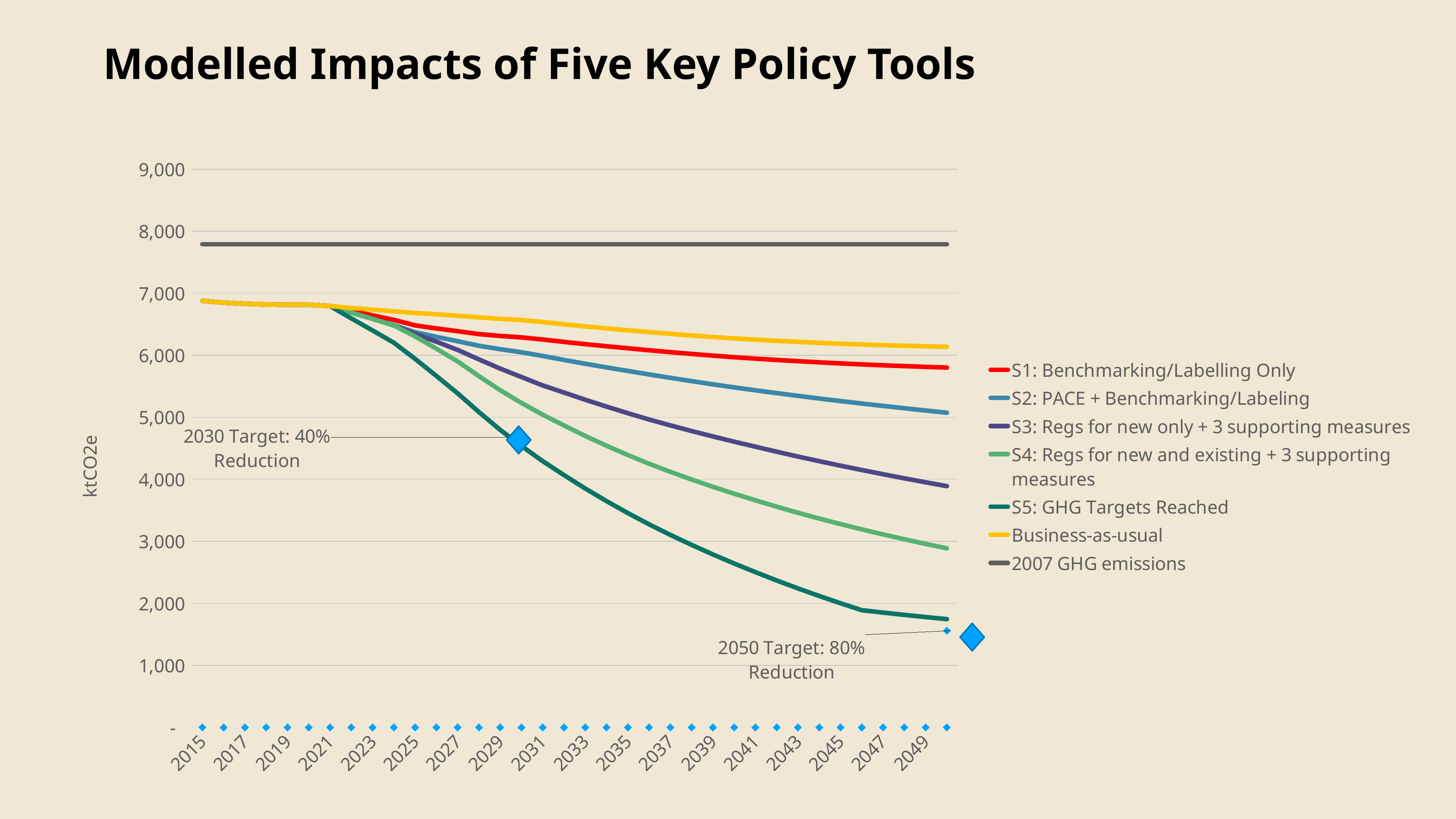
What is the label on the vertical axis? ktCO2e Is the value for 2007 GHG emissions greater or less than 8,000? less In 2049, which is larger: Business-as-usual or S2: PACE + Benchmarking/Labeling? Business-as-usual Is the value for S1: Benchmarking/Labelling Only in 2049 greater or less than 6,000? less What kind of chart is shown on the slide? line chart Does the S5: GHG Targets Reached line rise or fall from 2021 to 2049? fall Which series is highest across the whole chart? 2007 GHG emissions Is the value for S5: GHG Targets Reached in 2035 greater or less than 4,000? less Which series is lowest in 2049? S5: GHG Targets Reached What is the title of the chart? Modelled Impacts of Five Key Policy Tools How many series does the legend list? 7